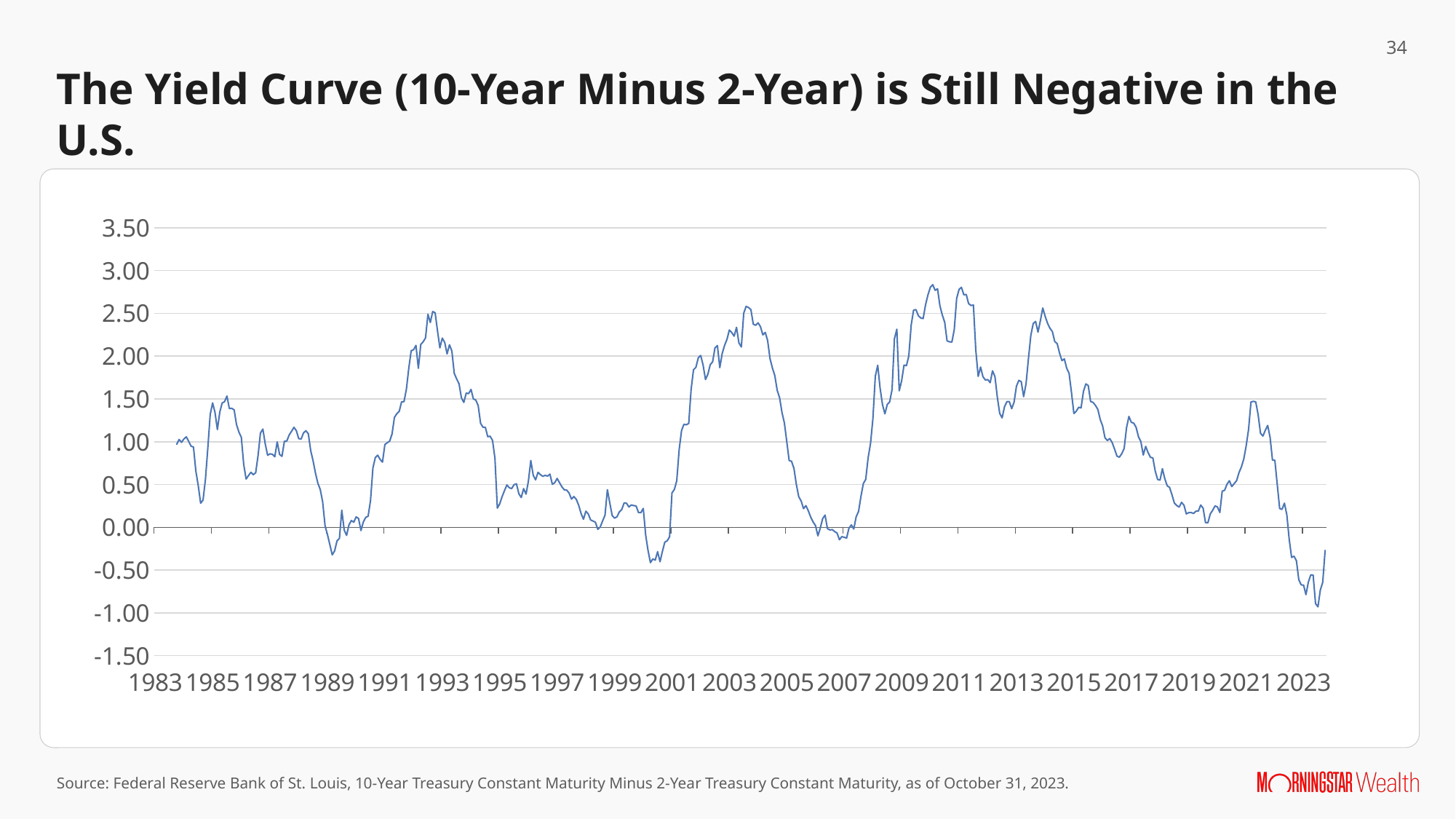
What kind of chart is shown on the slide? line chart Is the peak value of the yield curve around 2021 greater or less than 1.00? greater Is the value of the yield curve at the start of the series in 1983 greater or less than 0.50? greater Is the lowest value of the yield curve around 2000 greater or less than 0.00? less What is the title of the chart on the slide? The Yield Curve (10-Year Minus 2-Year) is Still Negative in the U.S. Does the yield curve rise or fall between 2007 and 2010? rise What is the highest value labelled on the y axis? 3.50 How many year labels are shown on the x axis? 21 Does the yield curve rise or fall between its 2021 peak and 2023? fall